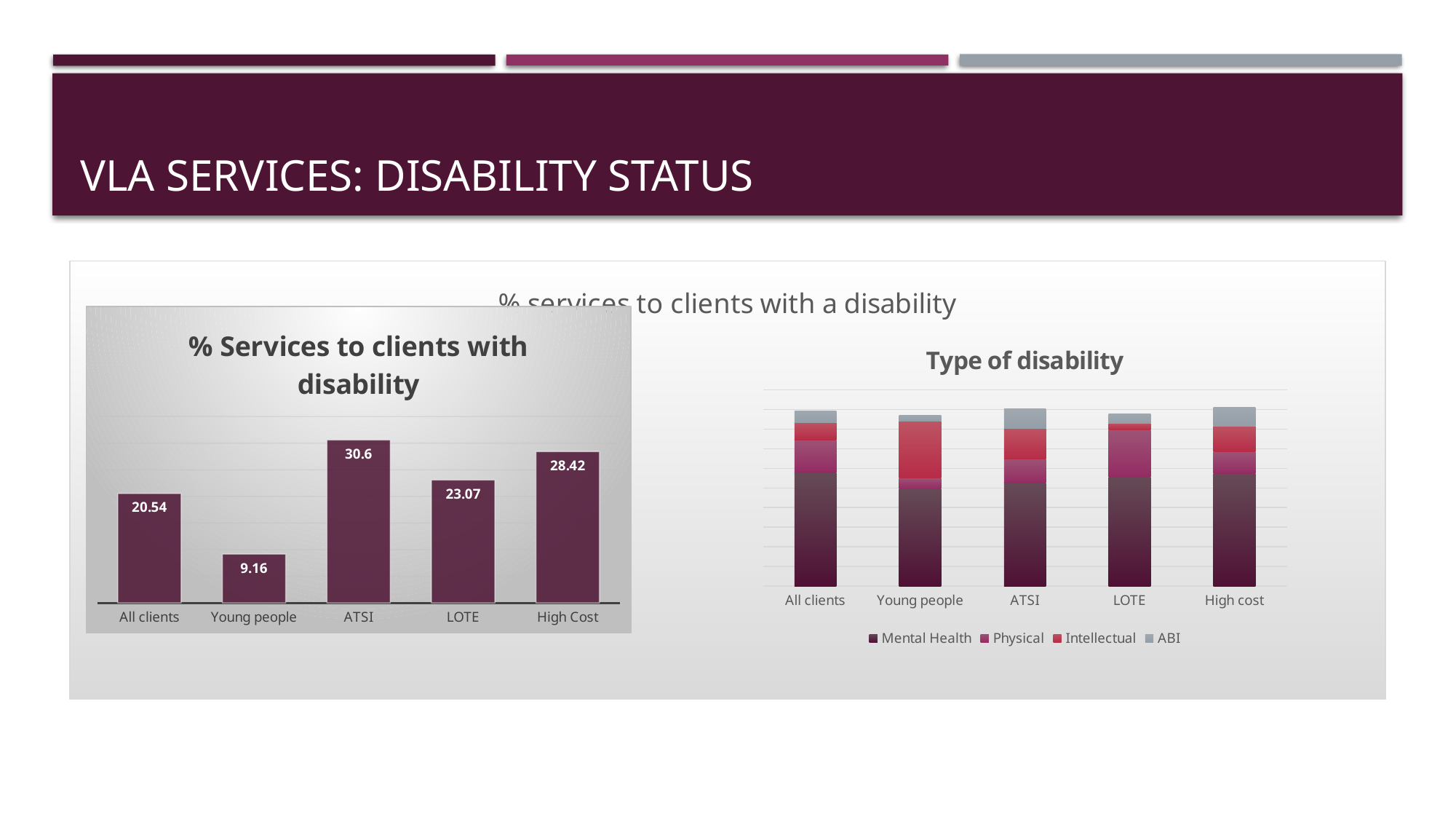
How many categories are shown in the '% Services to clients with disability' chart? 5 What kind of chart is the '% Services to clients with disability' chart? Bar chart How many series does the legend of the 'Type of disability' chart list? 4 In the '% Services to clients with disability' chart, what is the value for LOTE? 23.07 In the '% Services to clients with disability' chart, what is the value for Young people? 9.16 In the '% Services to clients with disability' chart, which is larger, the value for High Cost or the value for LOTE? High Cost In the '% Services to clients with disability' chart, which category has the lowest value? Young people In the 'Type of disability' chart, which category has the tallest stacked bar? High cost In the '% Services to clients with disability' chart, which category has the highest value? ATSI In the '% Services to clients with disability' chart, what is the value for ATSI? 30.6 What are the legend entries in the 'Type of disability' chart? Mental Health, Physical, Intellectual, ABI In the '% Services to clients with disability' chart, what is the difference between the values for ATSI and All clients? 10.06